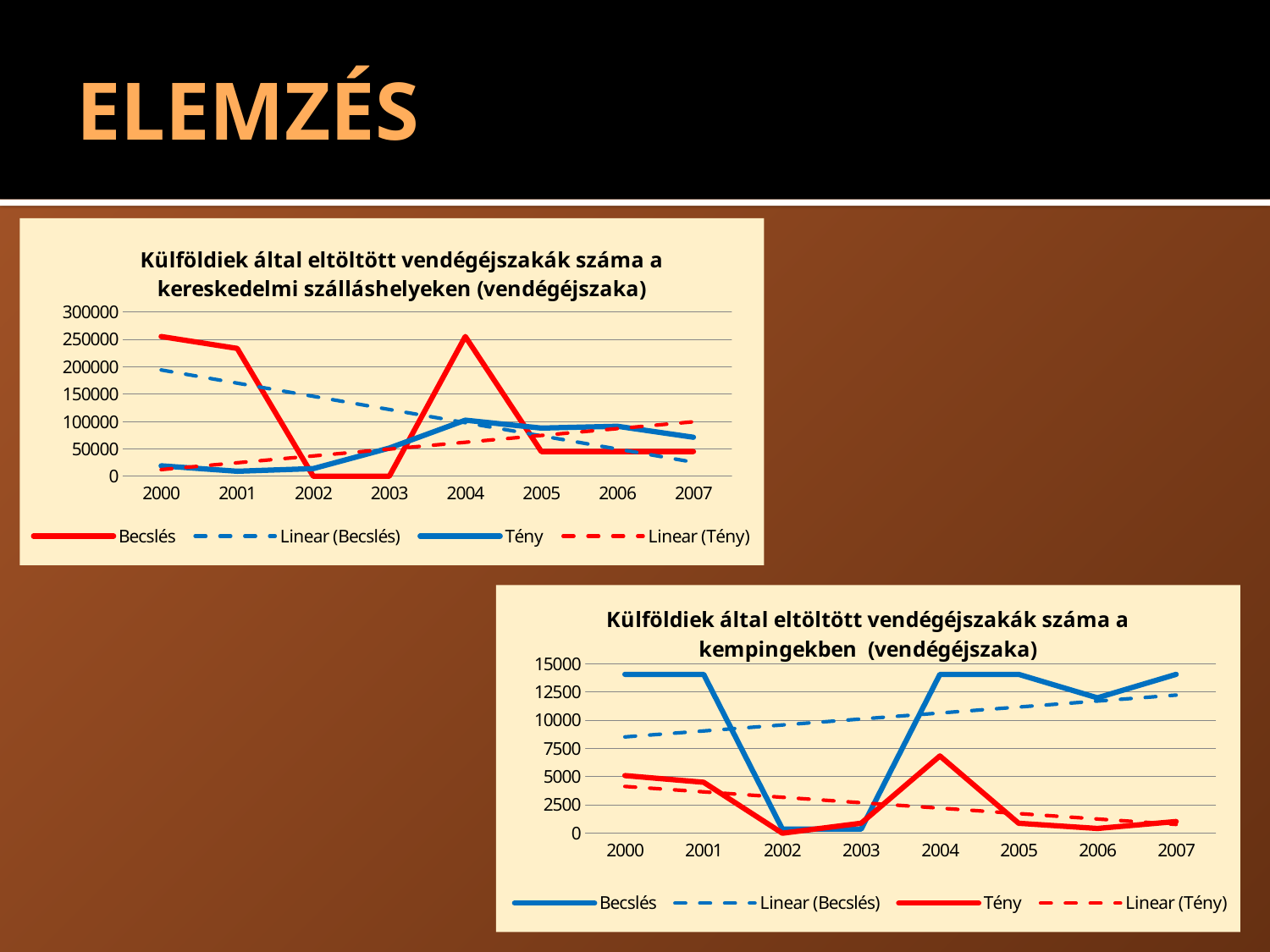
In the top chart (kereskedelmi szálláshelyek), is the Tény value for 2004 greater or less than 50000? greater In the top chart (kereskedelmi szálláshelyek), is the Becslés value for 2000 greater or less than 200000? greater In the bottom chart (kempingek), is the Becslés value for 2002 greater or less than 2500? less What type of chart is the top chart titled 'Külföldiek által eltöltött vendégéjszakák száma a kereskedelmi szálláshelyeken'? Line chart In the top chart (kereskedelmi szálláshelyek), in which year does the Tény series reach its highest value? 2004 In the bottom chart (kempingek), in which year does the Tény series reach its highest value? 2004 In the bottom chart (kempingek), does the Linear (Tény) trend line rise or fall from 2000 to 2007? Fall In the top chart (kereskedelmi szálláshelyek), does the Linear (Becslés) trend line rise or fall from 2000 to 2007? Fall In the bottom chart (kempingek), which colour is used for the Becslés line? Blue In the top chart (kereskedelmi szálláshelyek), which is larger in 2000, Becslés or Tény? Becslés How many years are shown on the x axis of the bottom chart about kempingek? 8 How many entries does the legend of the top chart (kereskedelmi szálláshelyek) list? 4